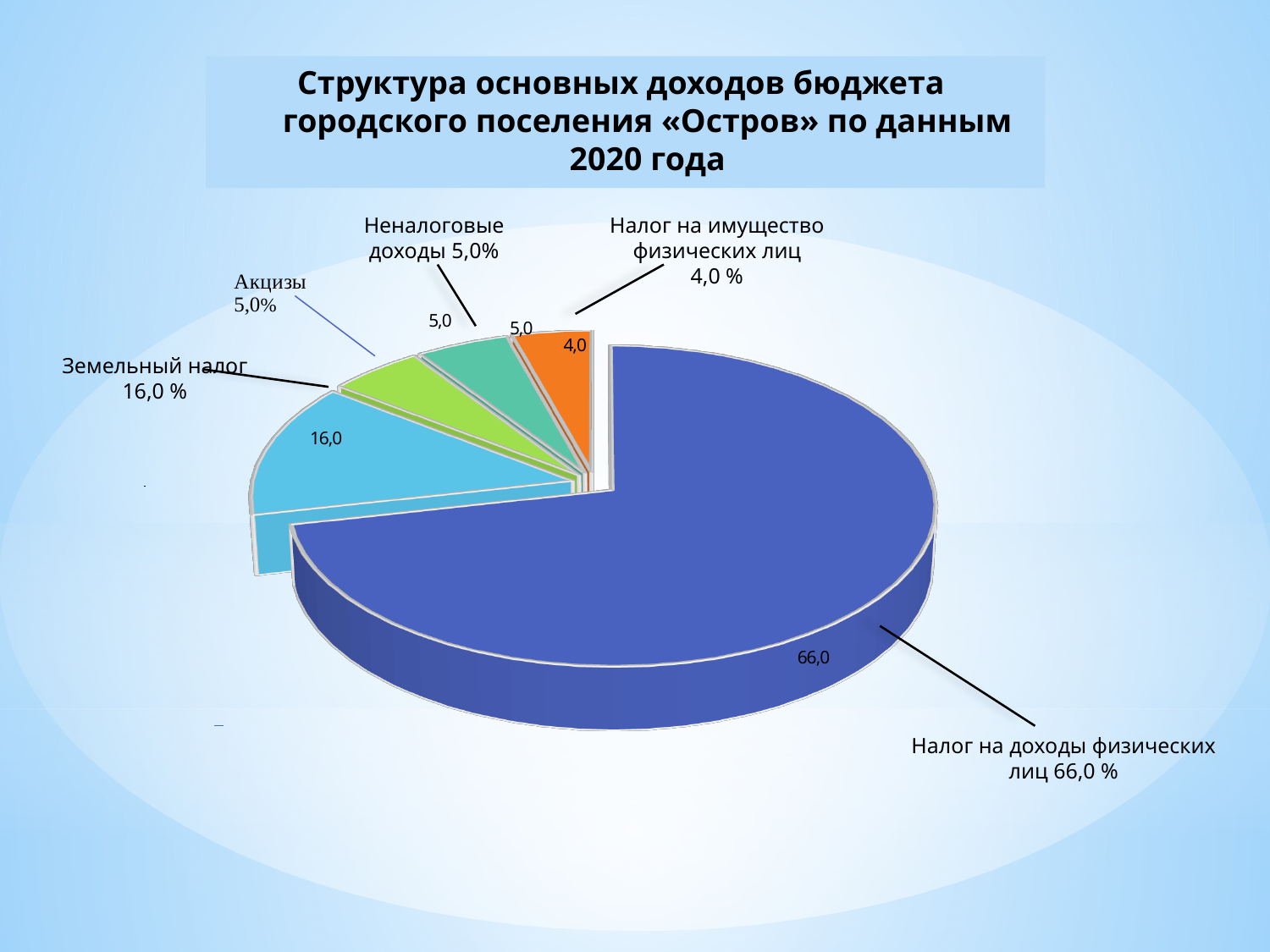
What year does the chart title say the data is for? 2020 Which category has the largest slice of the pie? Налог на доходы физических лиц Which category has the smallest slice of the pie? Налог на имущество физических лиц What share of the budget revenue is Налог на доходы физических лиц? 66,0 % What is the combined share of Акцизы and Неналоговые доходы? 10,0% What is the difference in percentage points between Налог на доходы физических лиц and Земельный налог? 50,0 How many slices does the pie chart have? 5 Which is larger, Земельный налог or Акцизы? Земельный налог What share of the budget revenue is Налог на имущество физических лиц? 4,0 % What share of the budget revenue is Неналоговые доходы? 5,0% What share of the budget revenue is Земельный налог? 16,0 % What kind of chart is shown on the slide? pie chart